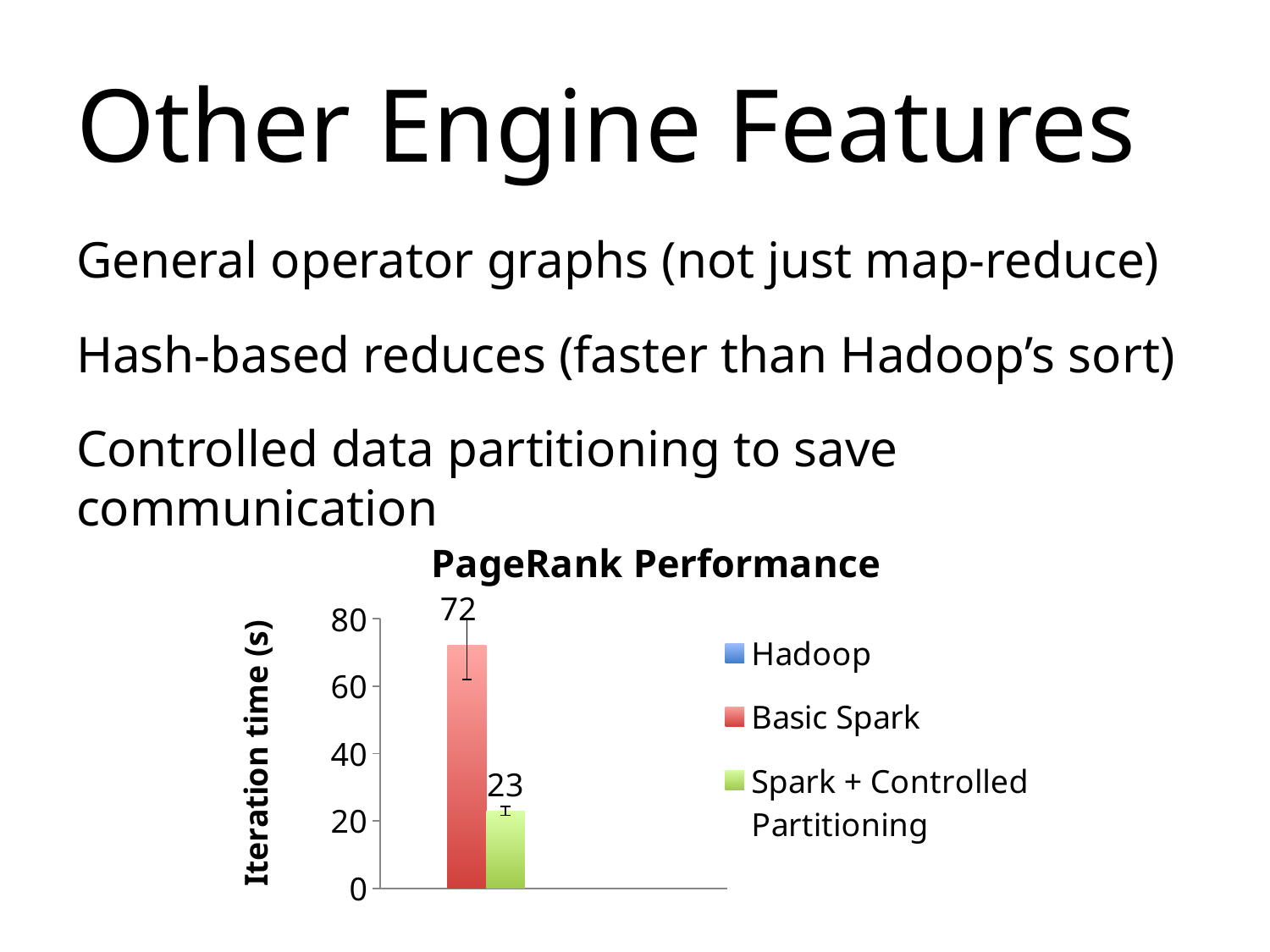
In the PageRank Performance chart, which has the larger iteration time: Basic Spark or Spark + Controlled Partitioning? Basic Spark In the PageRank Performance chart, which plotted series has the lowest iteration time? Spark + Controlled Partitioning In the PageRank Performance chart, what is the difference in iteration time between Basic Spark and Spark + Controlled Partitioning? 49 In the PageRank Performance chart, is the value for Spark + Controlled Partitioning greater or less than 40? less What is the label on the vertical axis of the PageRank Performance chart? Iteration time (s) In the PageRank Performance chart, what is the iteration time for Spark + Controlled Partitioning? 23 How many bars are plotted in the PageRank Performance chart? 2 What kind of chart is the PageRank Performance chart? bar chart How many series does the legend of the PageRank Performance chart list? 3 In the PageRank Performance chart, which plotted series has the highest iteration time? Basic Spark In the PageRank Performance chart, what is the iteration time for Basic Spark? 72 In the PageRank Performance chart, is the value for Basic Spark greater or less than 60? greater